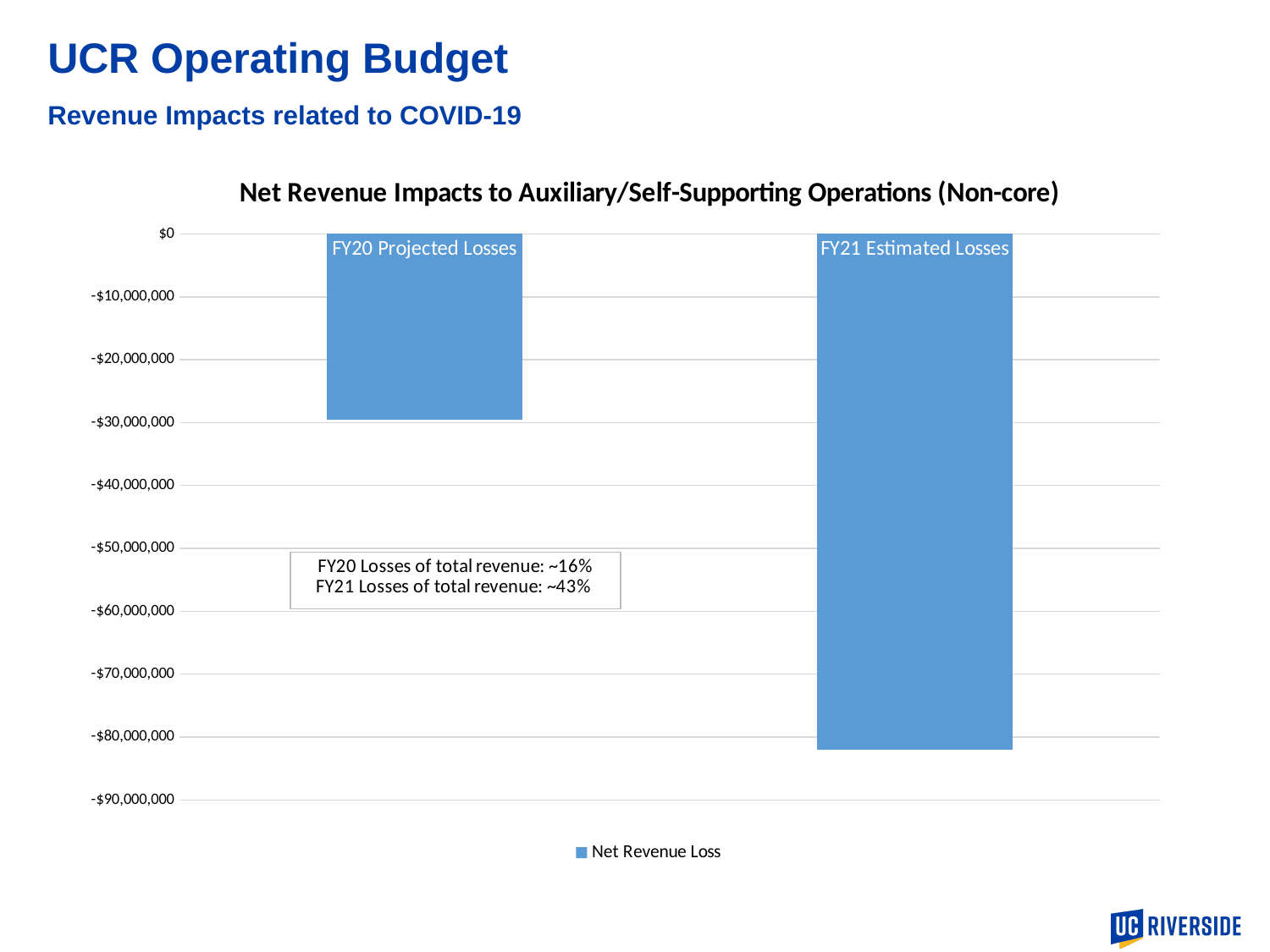
Is the value for FY21 Estimated Losses greater or less than -$90,000,000? greater Which category shows the larger net revenue loss? FY21 Estimated Losses Which category has the highest (least negative) value in the chart? FY20 Projected Losses Do the plotted values rise or fall from FY20 Projected Losses to FY21 Estimated Losses? Fall How many series does the chart legend list? 1 Which category has the lowest (most negative) value in the chart? FY21 Estimated Losses What type of chart is shown on the slide? Bar chart Is the value for FY21 Estimated Losses greater or less than -$70,000,000? less What series name is shown in the chart legend? Net Revenue Loss Is the value for FY20 Projected Losses greater or less than -$20,000,000? less What is the title of the chart? Net Revenue Impacts to Auxiliary/Self-Supporting Operations (Non-core) How many categories (bars) are plotted in the chart? 2